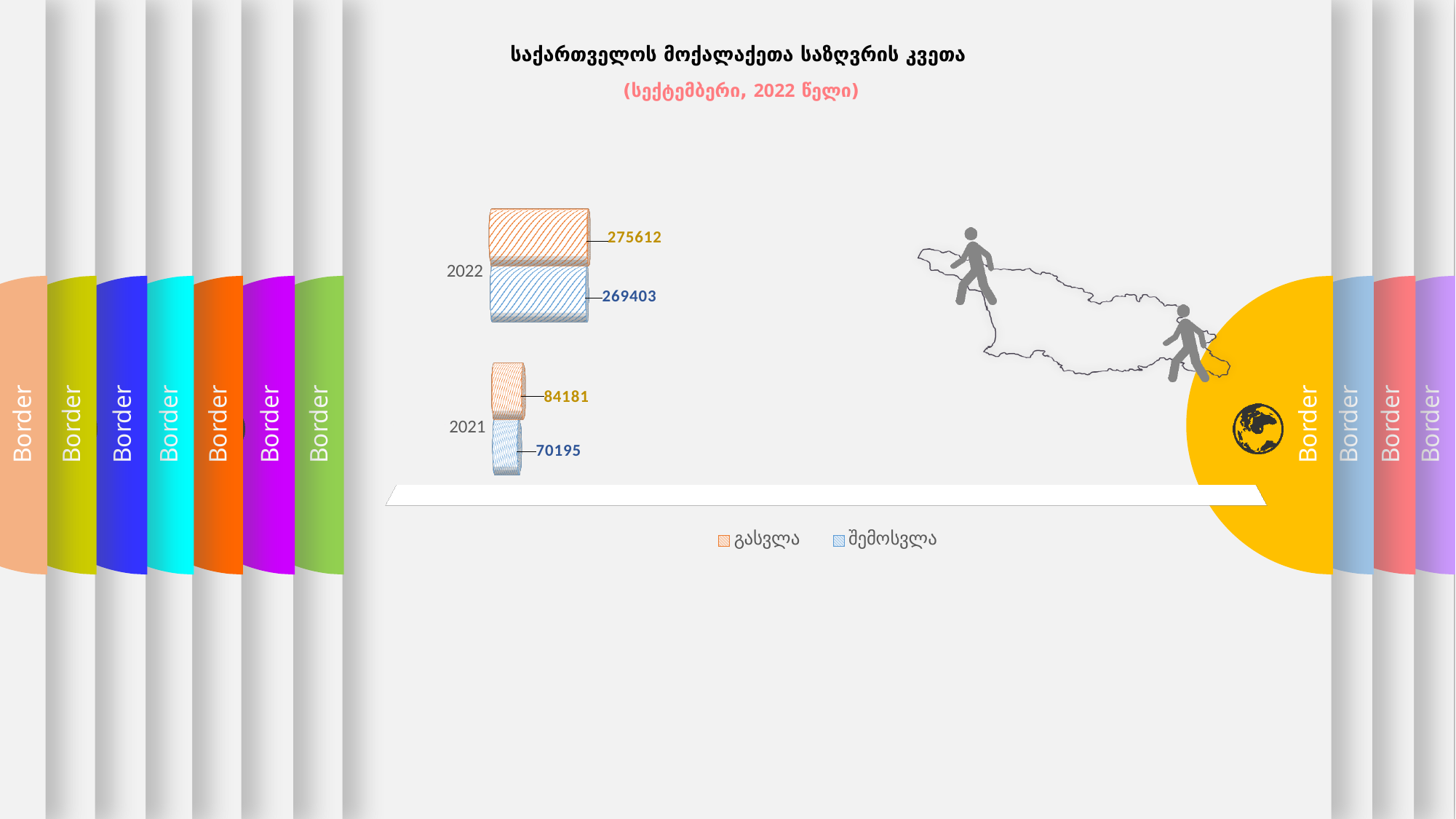
Which is larger in 2021, გასვლა or შემოსვლა? გასვლა Which year has the lowest value for შემოსვლა? 2021 What is the difference between გასვლა and შემოსვლა in 2021? 13986 What is the difference between გასვლა and შემოსვლა in 2022? 6209 What is the value for შემოსვლა in 2021? 70195 What is the value for შემოსვლა in 2022? 269403 Which year has the highest value for გასვლა? 2022 How many years are shown on the chart? 2 What is the value for გასვლა in 2021? 84181 What is the value for გასვლა in 2022? 275612 What kind of chart is shown on the slide? Bar chart How many series does the legend list? 2